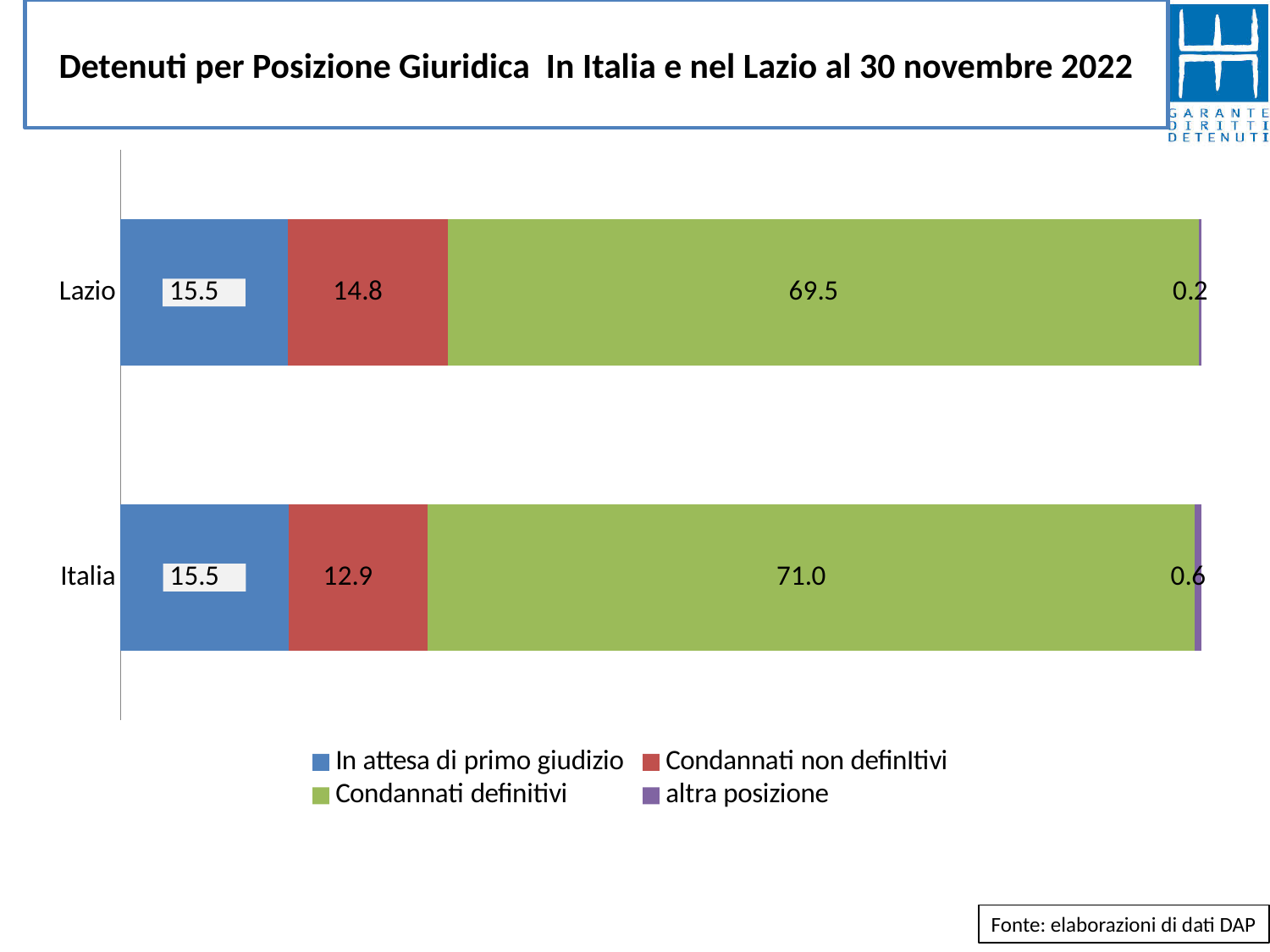
What is the value of In attesa di primo giudizio for Lazio? 15.5 What is the value of altra posizione for Italia? 0.6 How many series does the legend list? 4 Which has the larger Condannati definitivi value, Italia or Lazio? Italia What is the value of Condannati definitivi for Lazio? 69.5 What is the total of the stacked bar for Italia? 100.0 What is the value of altra posizione for Lazio? 0.2 What is the difference between the Condannati non definitivi values for Lazio and Italia? 1.9 What is the value of Condannati non definitivi for Italia? 12.9 What is the difference between the Condannati definitivi values for Italia and Lazio? 1.5 Which series has the highest value for Lazio? Condannati definitivi What kind of chart is shown on the slide? Stacked bar chart